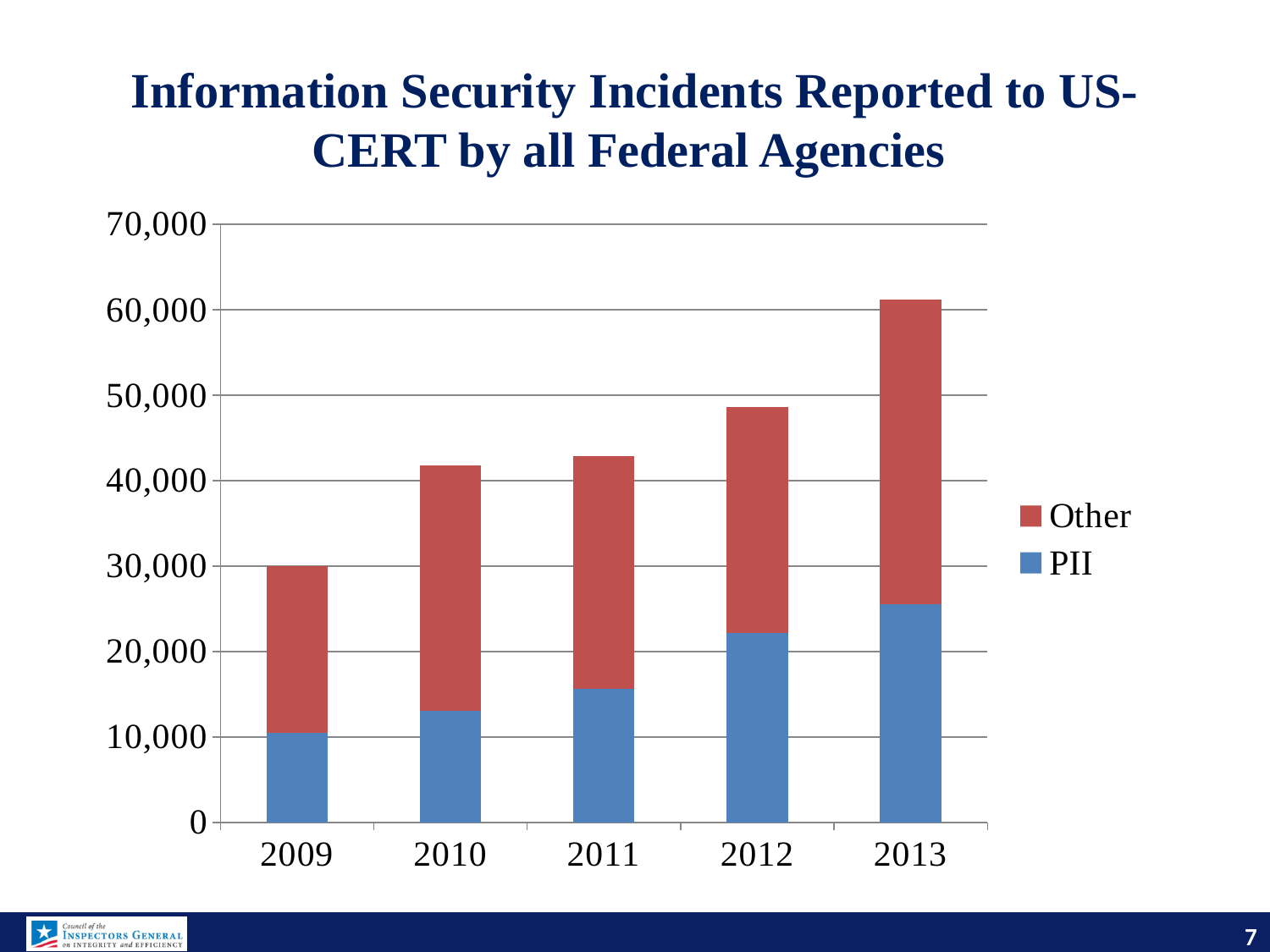
Which is larger, the PII value for 2013 or the PII value for 2010? 2013 What kind of chart is shown on the slide? bar chart Which series is shown in red in the chart? Other Which year has the highest total number of incidents? 2013 Do the total incidents rise or fall from 2009 to 2013? rise Is the PII value for 2013 greater or less than 20,000? greater How many years are shown on the x axis of the chart? 5 Is the PII value for 2011 greater or less than 20,000? less Is the total value for 2012 greater or less than 50,000? less Which year has the lowest total number of incidents? 2009 How many series does the legend list? 2